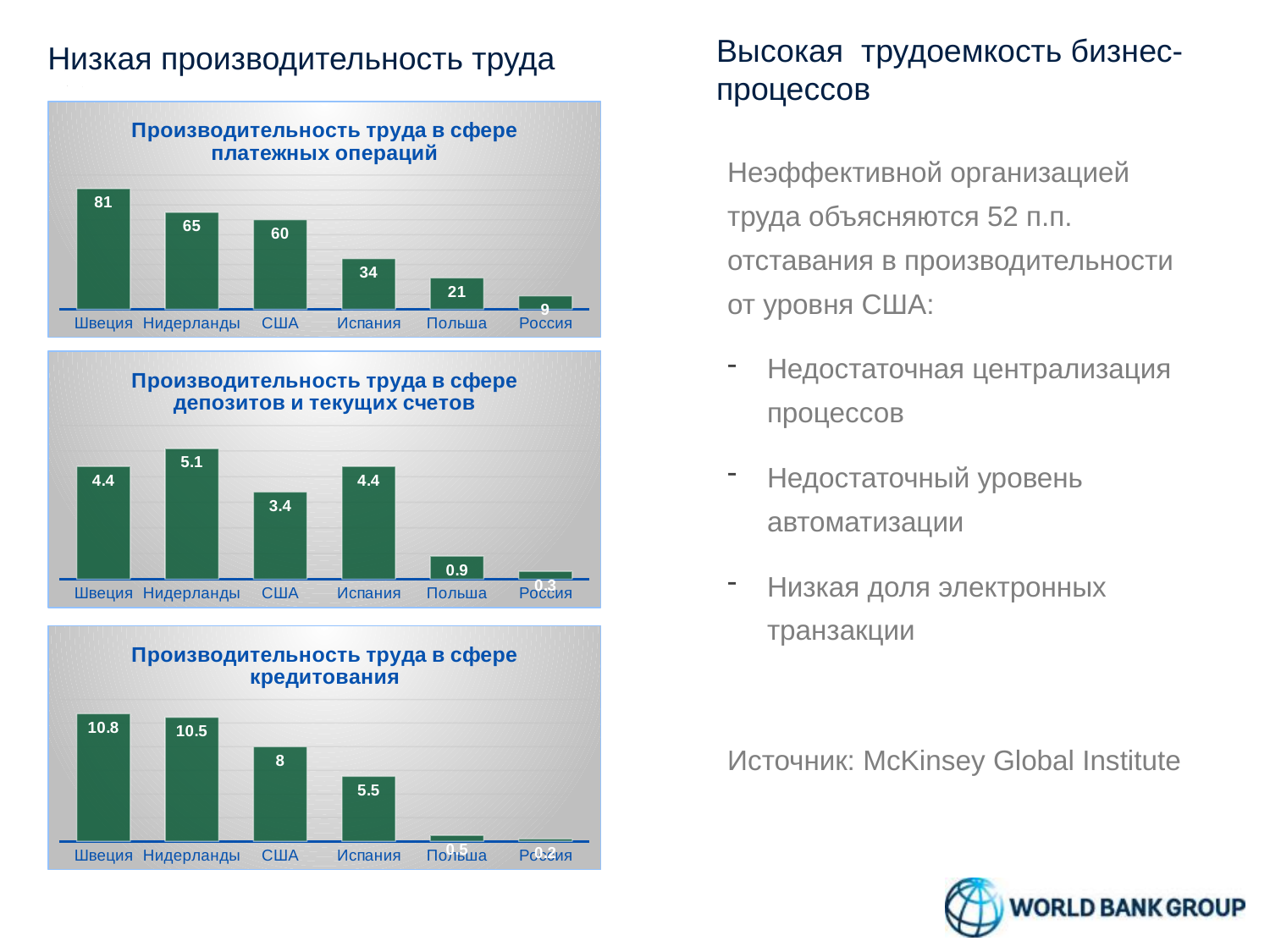
In the chart 'Производительность труда в сфере платежных операций', which country has the lowest value? Россия In the chart 'Производительность труда в сфере депозитов и текущих счетов', which country has the highest value? Нидерланды In the chart 'Производительность труда в сфере кредитования', what is the difference between Швеция and Нидерланды? 0.3 In the chart 'Производительность труда в сфере депозитов и текущих счетов', which is larger, the value for Испания or the value for США? Испания What type of chart is 'Производительность труда в сфере кредитования'? Bar chart How many charts are shown on the slide? 3 In the chart 'Производительность труда в сфере платежных операций', how many countries are shown? 6 In the chart 'Производительность труда в сфере платежных операций', what is the value for Швеция? 81 In the chart 'Производительность труда в сфере депозитов и текущих счетов', what is the value for Польша? 0.9 In the chart 'Производительность труда в сфере кредитования', what is the value for Испания? 5.5 In the chart 'Производительность труда в сфере депозитов и текущих счетов', what is the value for США? 3.4 In the chart 'Производительность труда в сфере платежных операций', what is the difference between Нидерланды and США? 5